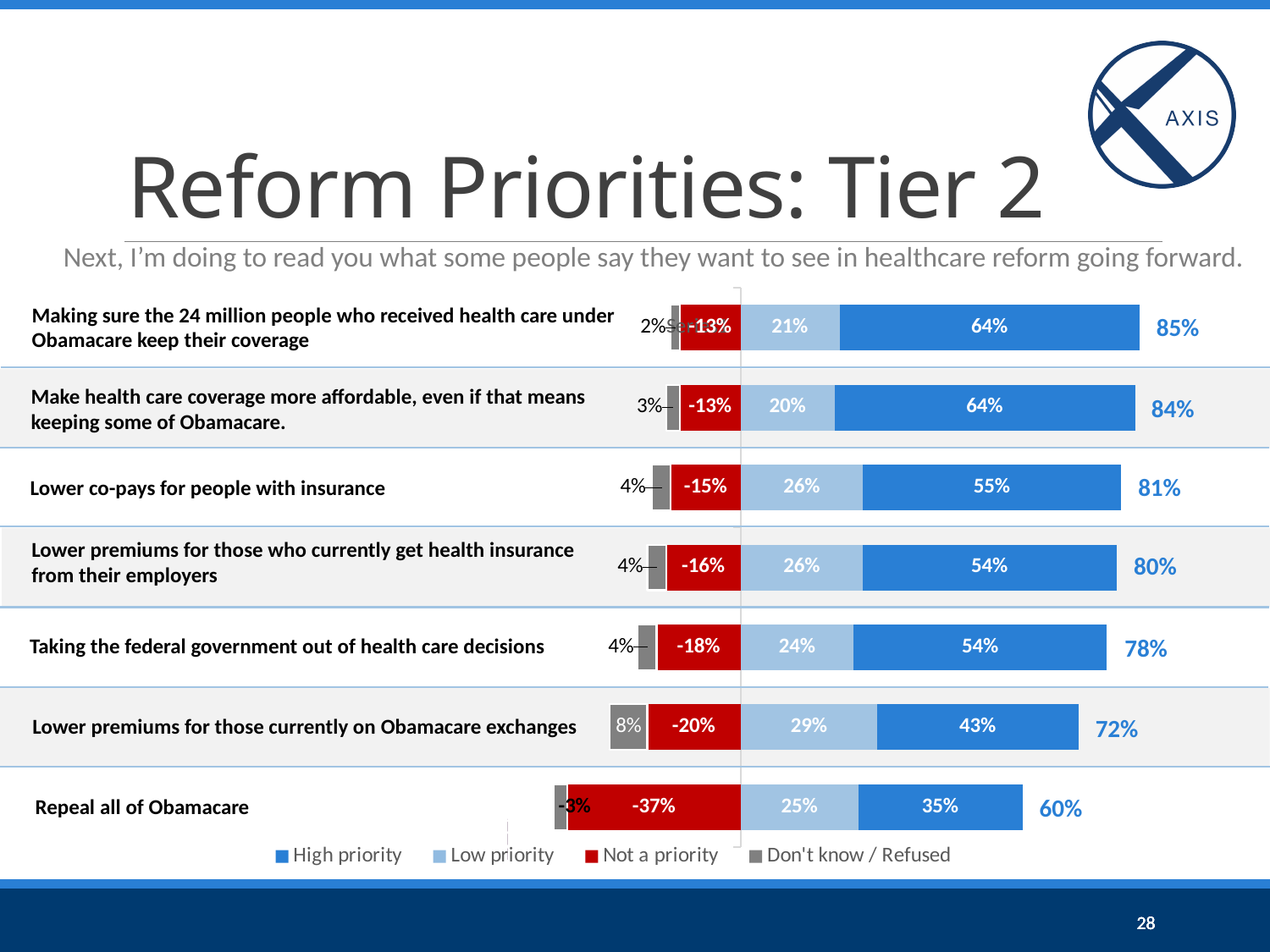
How many reform items are shown in the chart? 7 What kind of chart is shown on the slide? Stacked bar chart Which item has the largest Not a priority share? Repeal all of Obamacare Which has a larger Low priority value: "Lower premiums for those currently on Obamacare exchanges" or "Lower co-pays for people with insurance"? Lower premiums for those currently on Obamacare exchanges What is the High priority value for "Lower co-pays for people with insurance"? 55% What is the Low priority value for "Lower premiums for those currently on Obamacare exchanges"? 29% What is the Don't know / Refused value for "Lower premiums for those currently on Obamacare exchanges"? 8% How many series does the legend list? 4 Which item has the lowest High priority value? Repeal all of Obamacare What is the difference in High priority values between "Lower co-pays for people with insurance" and "Repeal all of Obamacare"? 20 percentage points What is the Not a priority value for "Repeal all of Obamacare"? -37% What is the combined High priority and Low priority total shown for "Taking the federal government out of health care decisions"? 78%